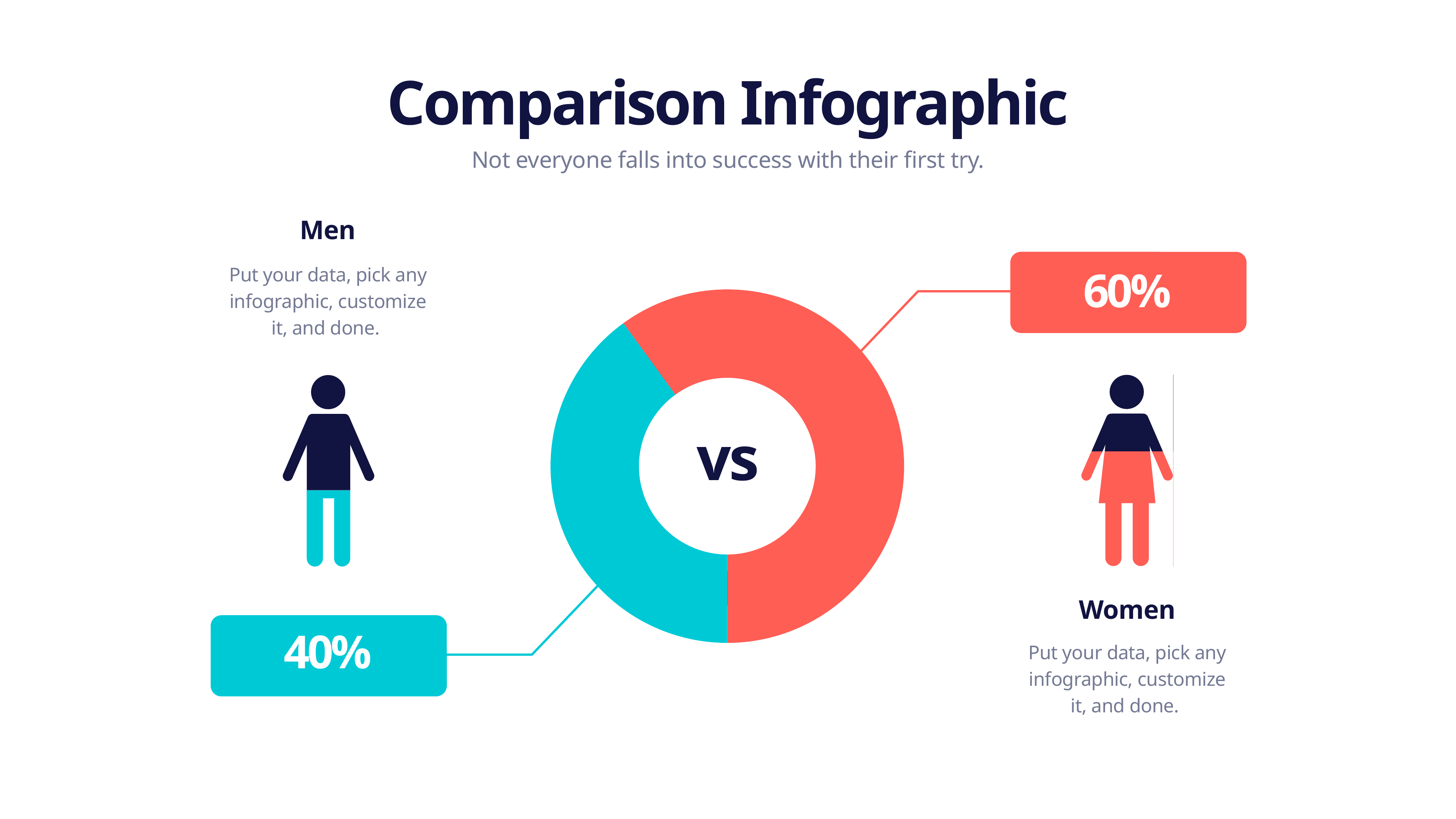
Which group has the smallest share of the donut chart? Men What is the total of the two percentages shown? 100% Which group has the largest share of the donut chart? Women What text appears in the centre of the donut chart? VS What kind of chart is shown on the slide? Donut chart What percentage is shown for Women? 60% What is the difference in percentage points between Women and Men? 20 What percentage is shown for Men? 40% Which group has the larger share, Men or Women? Women How many groups are compared in the donut chart? 2 What colour represents Men in the donut chart? Teal